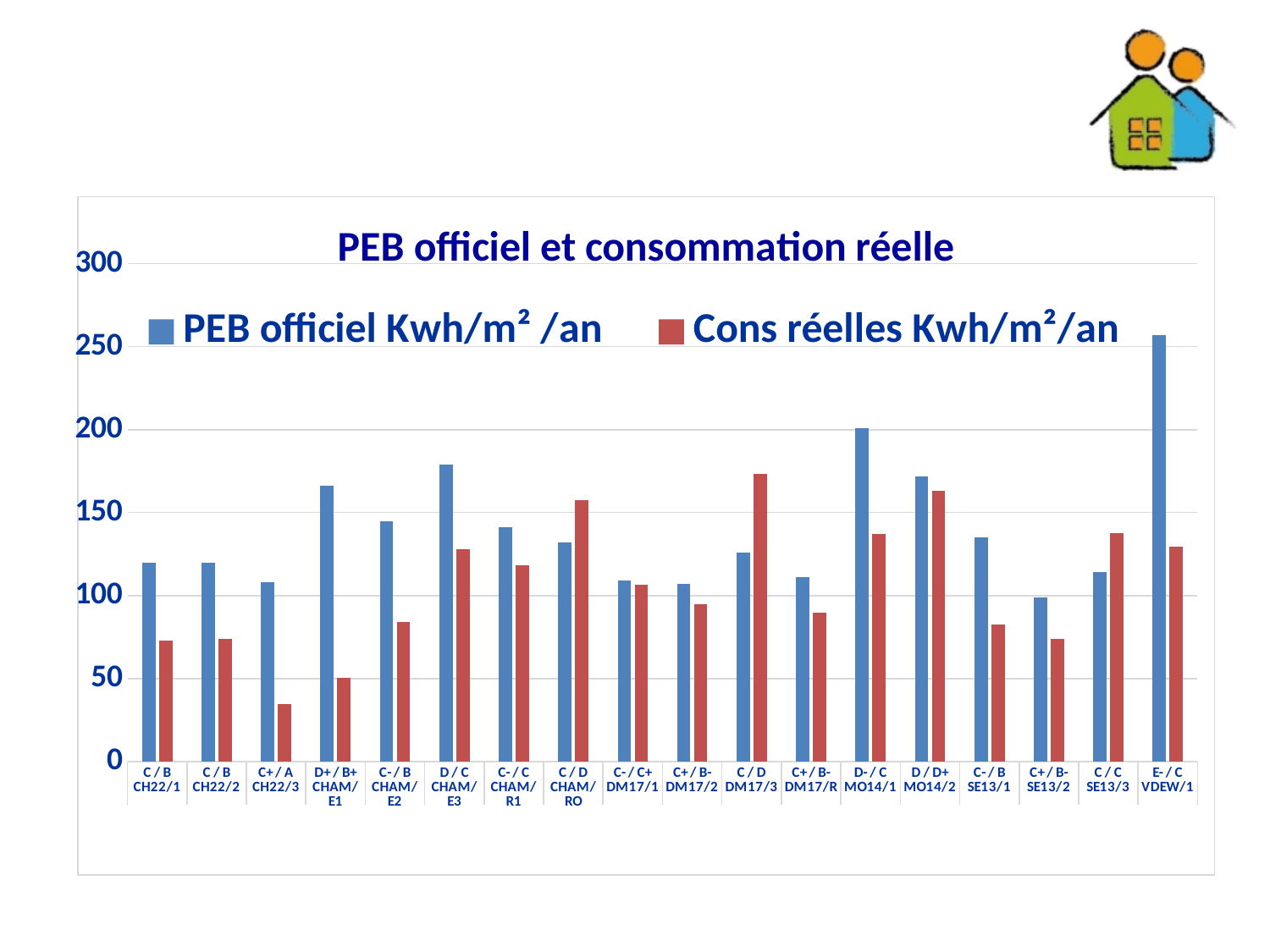
Is the PEB officiel value for E- / C VDEW/1 greater or less than 250? greater Which category has the highest PEB officiel Kwh/m² /an value? E- / C VDEW/1 Which category has the highest Cons réelles Kwh/m²/an value? C / D DM17/3 For C / B CH22/1, which is larger: PEB officiel or Cons réelles? PEB officiel For C / D DM17/3, which is larger: PEB officiel or Cons réelles? Cons réelles Which category has the lowest Cons réelles Kwh/m²/an value? C+ / A CH22/3 How many categories (dwellings) are shown on the x axis? 18 Is the Cons réelles value for C+ / A CH22/3 greater or less than 50? less What kind of chart is shown on the slide? bar chart What is the title of the chart? PEB officiel et consommation réelle Is the PEB officiel value for D / C CHAM/E3 greater or less than 150? greater How many series does the legend list? 2